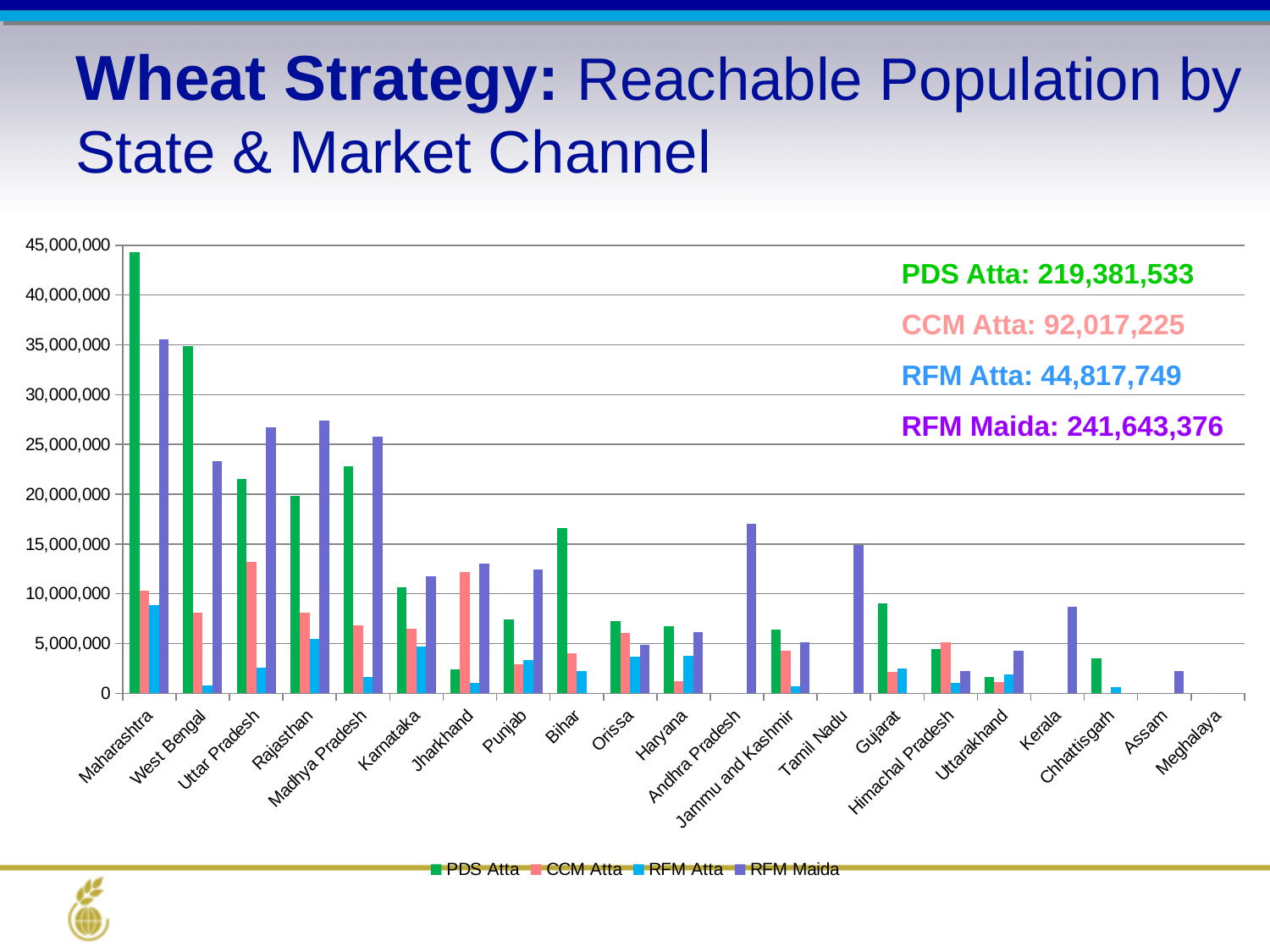
Is the RFM Maida value for Rajasthan greater or less than 25,000,000? greater How many states are shown on the x axis of the chart? 21 What total is printed on the slide for RFM Maida? 241,643,376 What kind of chart is shown on the slide? Bar chart What total is printed on the slide for CCM Atta? 92,017,225 Which state has the highest PDS Atta value? Maharashtra How many series does the legend list? 4 Is the RFM Maida value for Andhra Pradesh greater or less than 15,000,000? greater Which colour represents RFM Atta in the legend? Blue For Jharkhand, which is larger: PDS Atta or CCM Atta? CCM Atta Is the PDS Atta value for Maharashtra greater or less than 40,000,000? greater For Uttar Pradesh, which is larger: PDS Atta or RFM Maida? RFM Maida